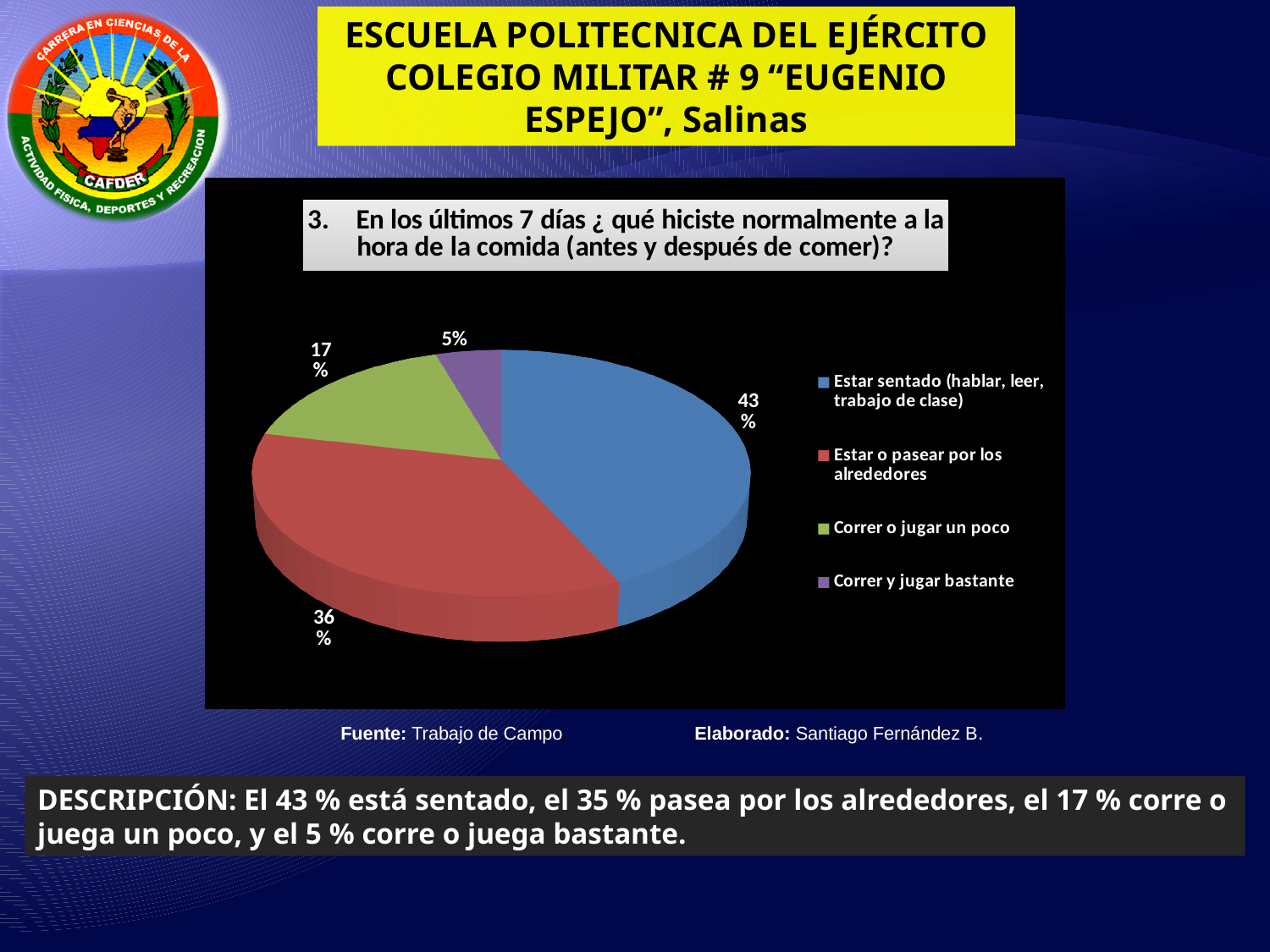
Which is larger: the share for "Correr o jugar un poco" or the share for "Correr y jugar bastante"? Correr o jugar un poco What kind of chart is shown on the slide? pie chart What percentage is shown for "Correr y jugar bastante"? 5% Which category has the smallest share of the pie? Correr y jugar bastante Which category has the largest share of the pie? Estar sentado (hablar, leer, trabajo de clase) How many categories does the pie chart show? 4 What is the difference between the shares for "Correr o jugar un poco" and "Correr y jugar bastante"? 12% What colour is the slice for "Correr o jugar un poco"? green What is the difference between the shares for "Estar sentado (hablar, leer, trabajo de clase)" and "Estar o pasear por los alrededores"? 7% What percentage is shown for "Correr o jugar un poco"? 17% What percentage is shown for "Estar o pasear por los alrededores"? 36% What percentage is shown for "Estar sentado (hablar, leer, trabajo de clase)"? 43%